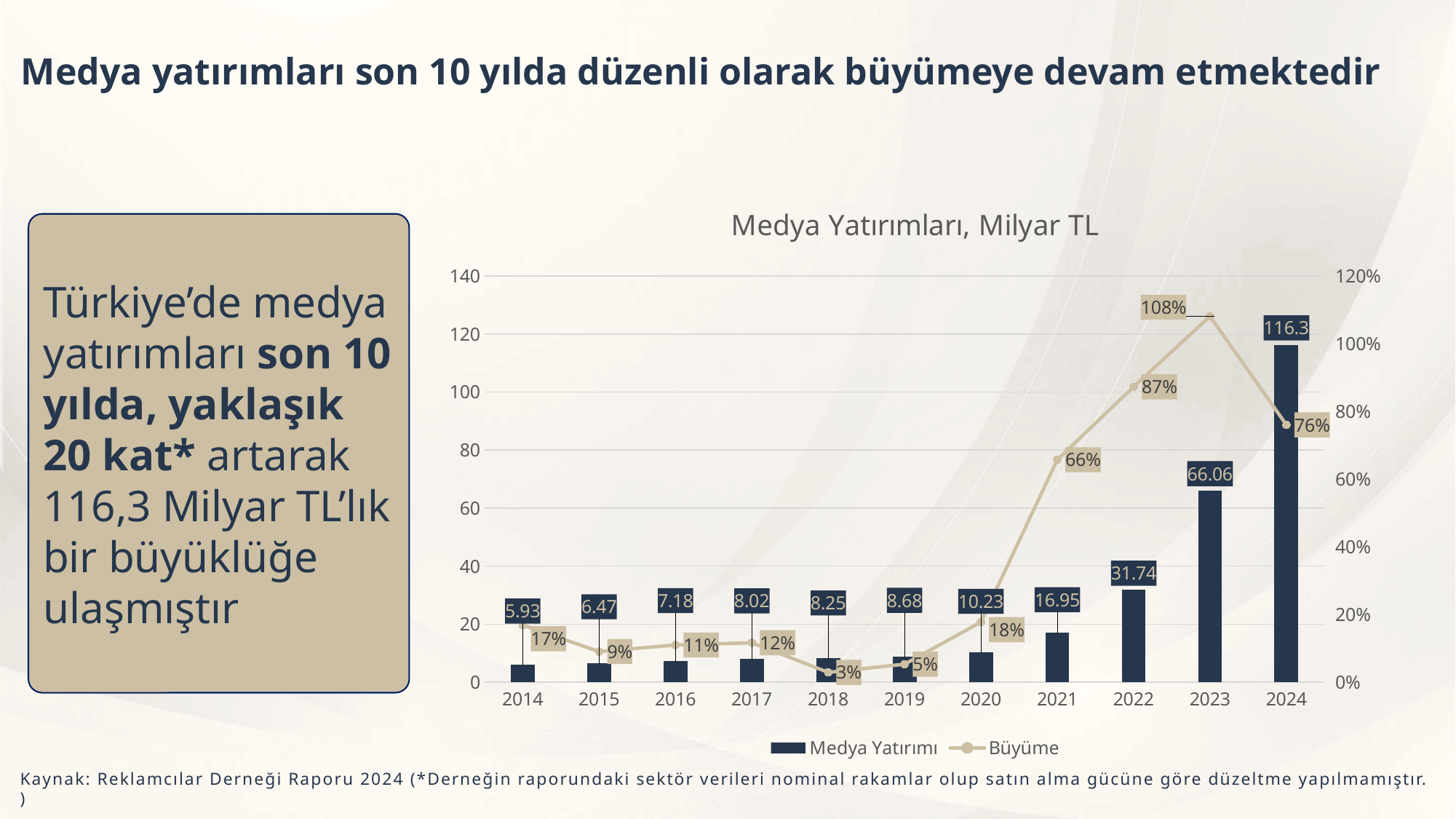
What is the title of the chart? Medya Yatırımları, Milyar TL What is the value of Medya Yatırımı for 2021? 16.95 Which year has the lowest Büyüme value? 2018 How many series does the legend list? 2 What kind of chart is this? Combined bar and line chart How many years are shown on the x axis? 11 What is the Büyüme value for 2023? 108% What is the value of Medya Yatırımı for 2024? 116.3 Which is larger, the Büyüme value for 2022 or for 2024? 2022 Which year has the highest Medya Yatırımı value? 2024 Do the Medya Yatırımı values rise or fall from 2014 to 2024? Rise What is the difference between the Medya Yatırımı values for 2023 and 2022? 34.32